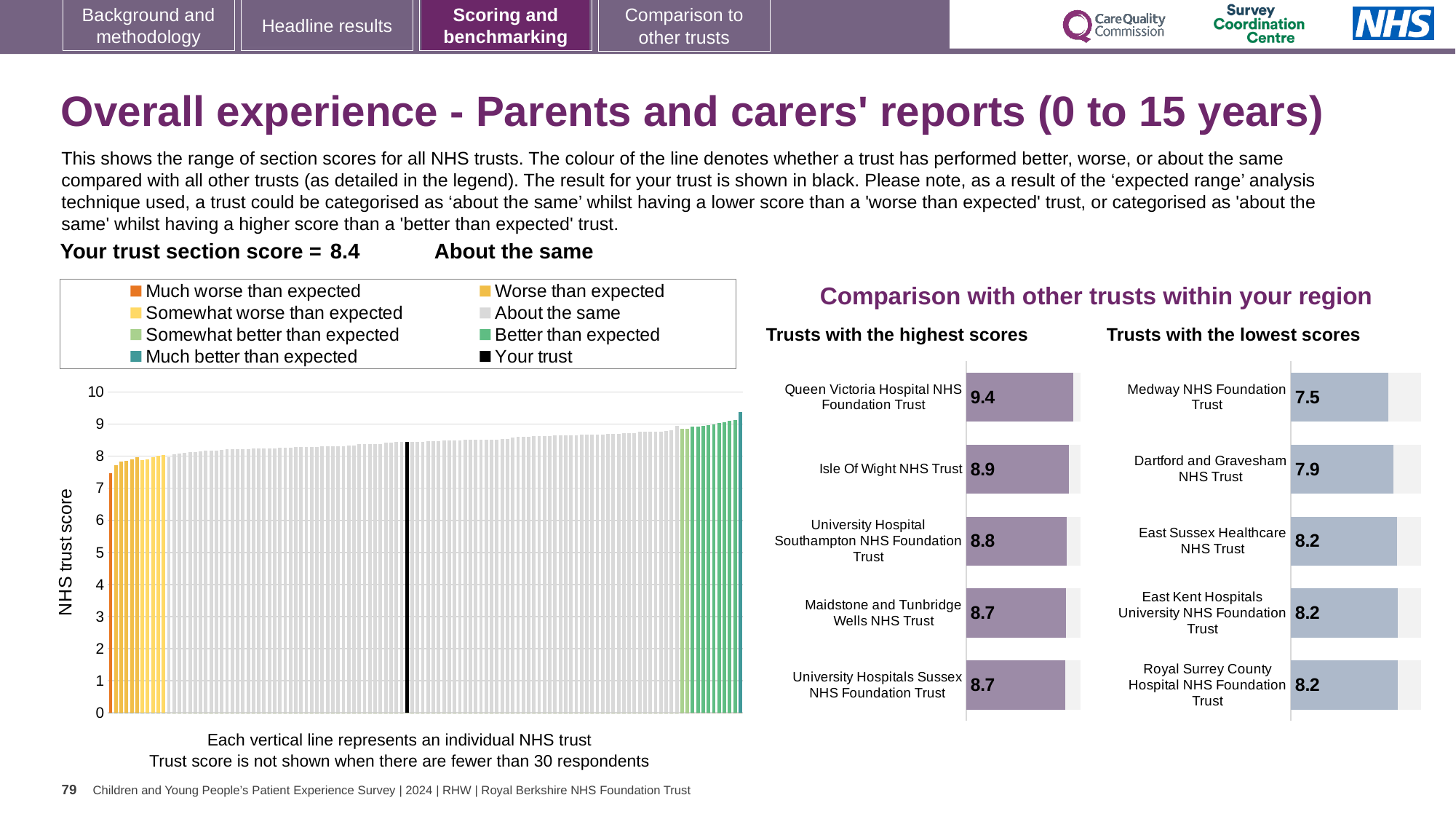
In the 'Trusts with the lowest scores' chart, which trust has the lowest score? Medway NHS Foundation Trust In the 'NHS trust score' chart on the left, do the trust scores rise or fall from left to right? Rise In the 'Trusts with the highest scores' chart, what is the score for Queen Victoria Hospital NHS Foundation Trust? 9.4 In the 'Trusts with the highest scores' chart, what is the difference between the scores of Queen Victoria Hospital NHS Foundation Trust and Isle Of Wight NHS Trust? 0.5 How many trusts are listed in the 'Trusts with the highest scores' chart? 5 In the 'Trusts with the lowest scores' chart, what is the score for Medway NHS Foundation Trust? 7.5 In the 'Trusts with the highest scores' chart, which trust has the highest score? Queen Victoria Hospital NHS Foundation Trust In the 'Trusts with the lowest scores' chart, which has the larger score: Medway NHS Foundation Trust or East Sussex Healthcare NHS Trust? East Sussex Healthcare NHS Trust What kind of chart is the 'NHS trust score' chart on the left of the slide? Bar chart What is the difference between the score for Queen Victoria Hospital NHS Foundation Trust in the highest scores chart and the score for Medway NHS Foundation Trust in the lowest scores chart? 1.9 In the 'Trusts with the highest scores' chart, what is the score for University Hospital Southampton NHS Foundation Trust? 8.8 In the 'Trusts with the lowest scores' chart, what is the score for Dartford and Gravesham NHS Trust? 7.9